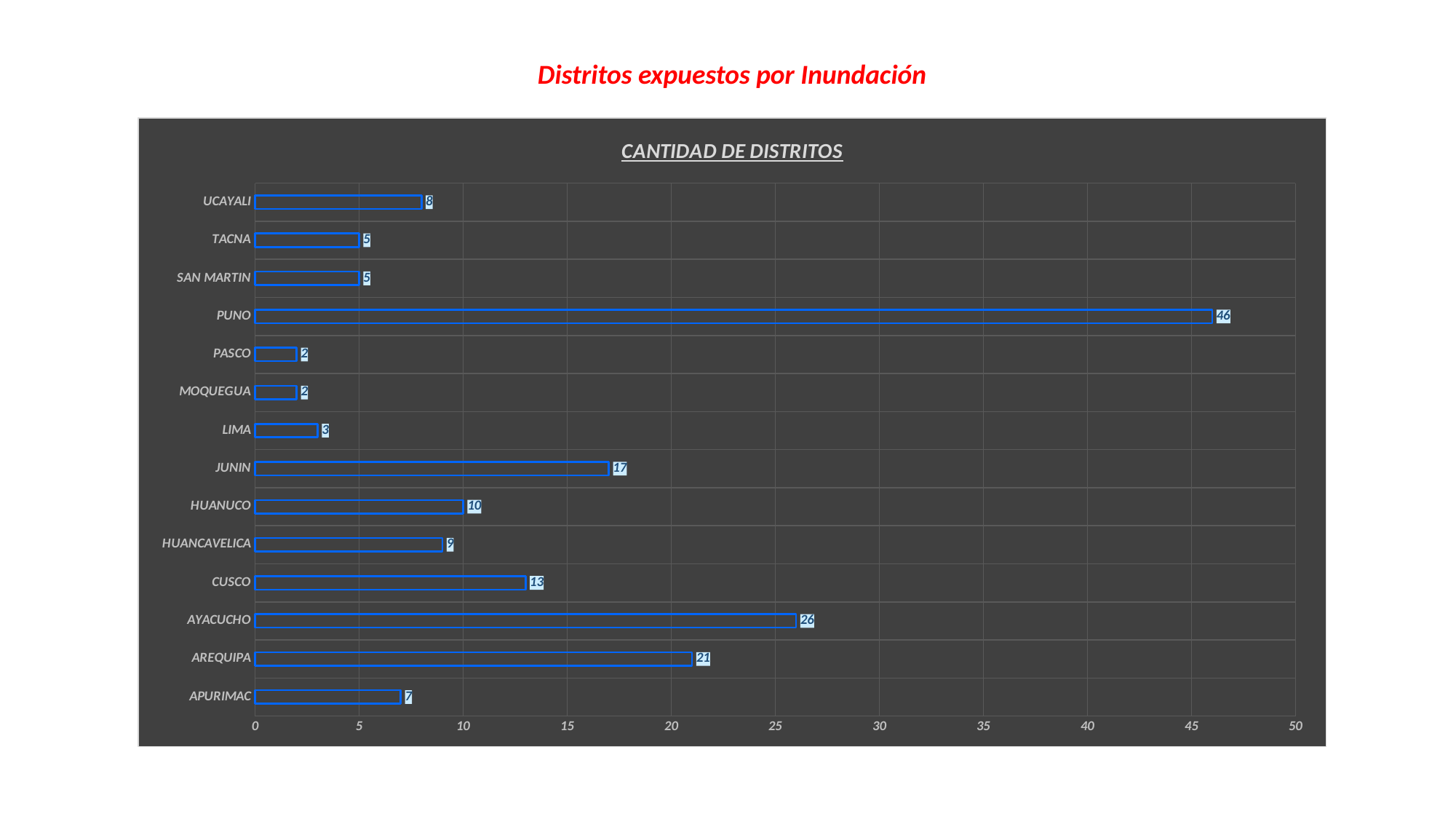
What is the difference between the values for PUNO and AYACUCHO? 20 What is the difference between the values for AYACUCHO and AREQUIPA? 5 What kind of chart is shown on the slide? bar chart What is the title of the chart? CANTIDAD DE DISTRITOS How many categories are shown on the chart? 14 What is the value for UCAYALI? 8 Which category has the highest value? PUNO What is the value for PUNO? 46 What is the value for AYACUCHO? 26 What is the value for HUANCAVELICA? 9 Is the value for AREQUIPA greater or less than 20? greater Which is larger, the value for JUNIN or the value for CUSCO? JUNIN